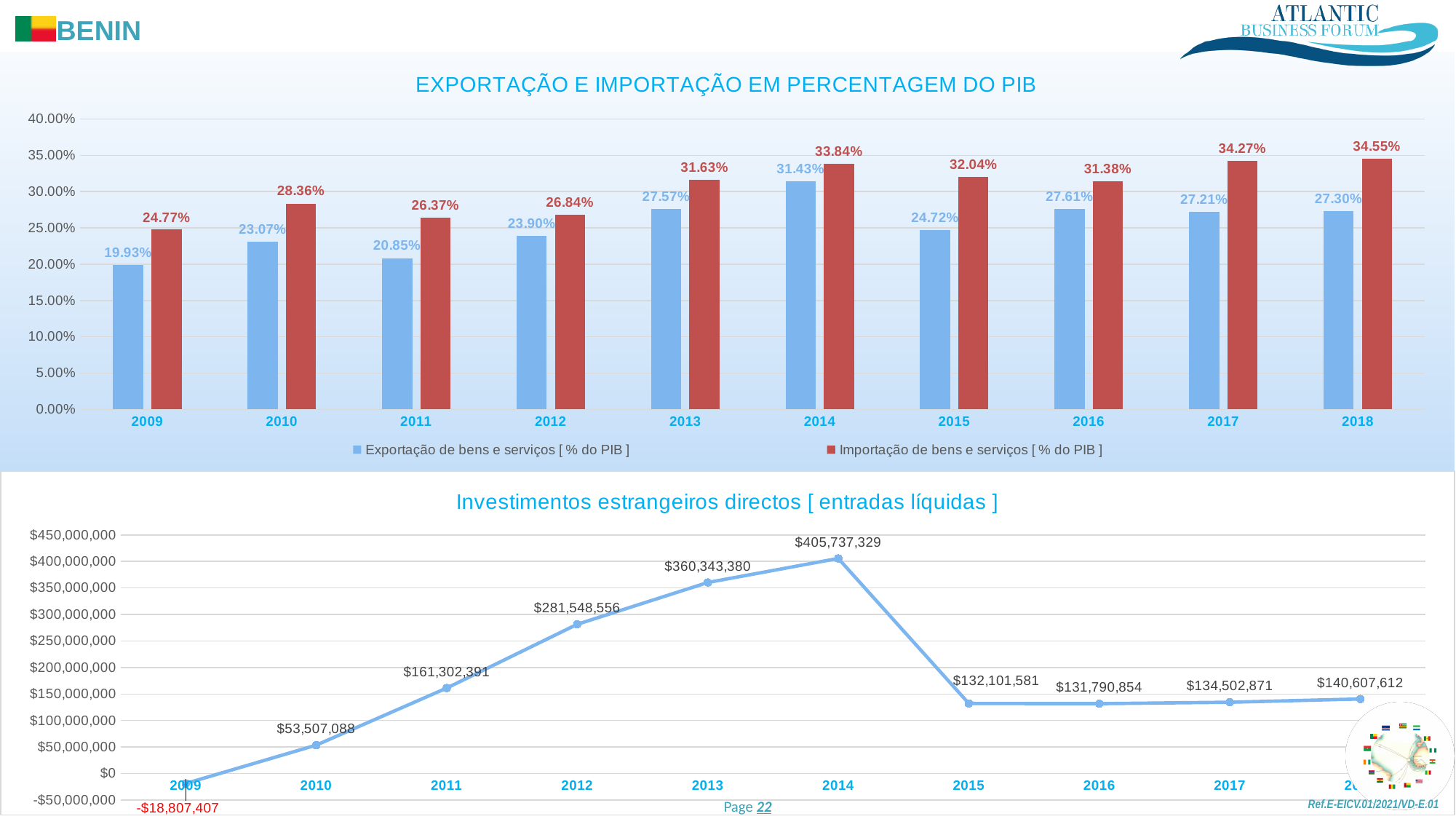
In the chart titled 'EXPORTAÇÃO E IMPORTAÇÃO EM PERCENTAGEM DO PIB', which year has the lowest Exportação de bens e serviços value? 2009 In the chart titled 'EXPORTAÇÃO E IMPORTAÇÃO EM PERCENTAGEM DO PIB', what is the value of Exportação de bens e serviços [ % do PIB ] for 2014? 31.43% In the chart titled 'Investimentos estrangeiros directos [ entradas líquidas ]', what kind of chart is shown? Line chart In the chart titled 'Investimentos estrangeiros directos [ entradas líquidas ]', what is the value for 2013? $360,343,380 In the chart titled 'EXPORTAÇÃO E IMPORTAÇÃO EM PERCENTAGEM DO PIB', what is the difference between the Importação and Exportação values for 2018? 7.25% In the chart titled 'EXPORTAÇÃO E IMPORTAÇÃO EM PERCENTAGEM DO PIB', how many series does the legend list? 2 In the chart titled 'Investimentos estrangeiros directos [ entradas líquidas ]', is the value for 2016 larger or smaller than the value for 2017? Smaller In the chart titled 'EXPORTAÇÃO E IMPORTAÇÃO EM PERCENTAGEM DO PIB', what is the value of Importação de bens e serviços [ % do PIB ] for 2011? 26.37% In the chart titled 'EXPORTAÇÃO E IMPORTAÇÃO EM PERCENTAGEM DO PIB', what kind of chart is shown? Bar chart In the chart titled 'EXPORTAÇÃO E IMPORTAÇÃO EM PERCENTAGEM DO PIB', which year has the highest Importação de bens e serviços value? 2018 In the chart titled 'Investimentos estrangeiros directos [ entradas líquidas ]', which year has the highest value? 2014 In the chart titled 'Investimentos estrangeiros directos [ entradas líquidas ]', which year has the lowest value? 2009